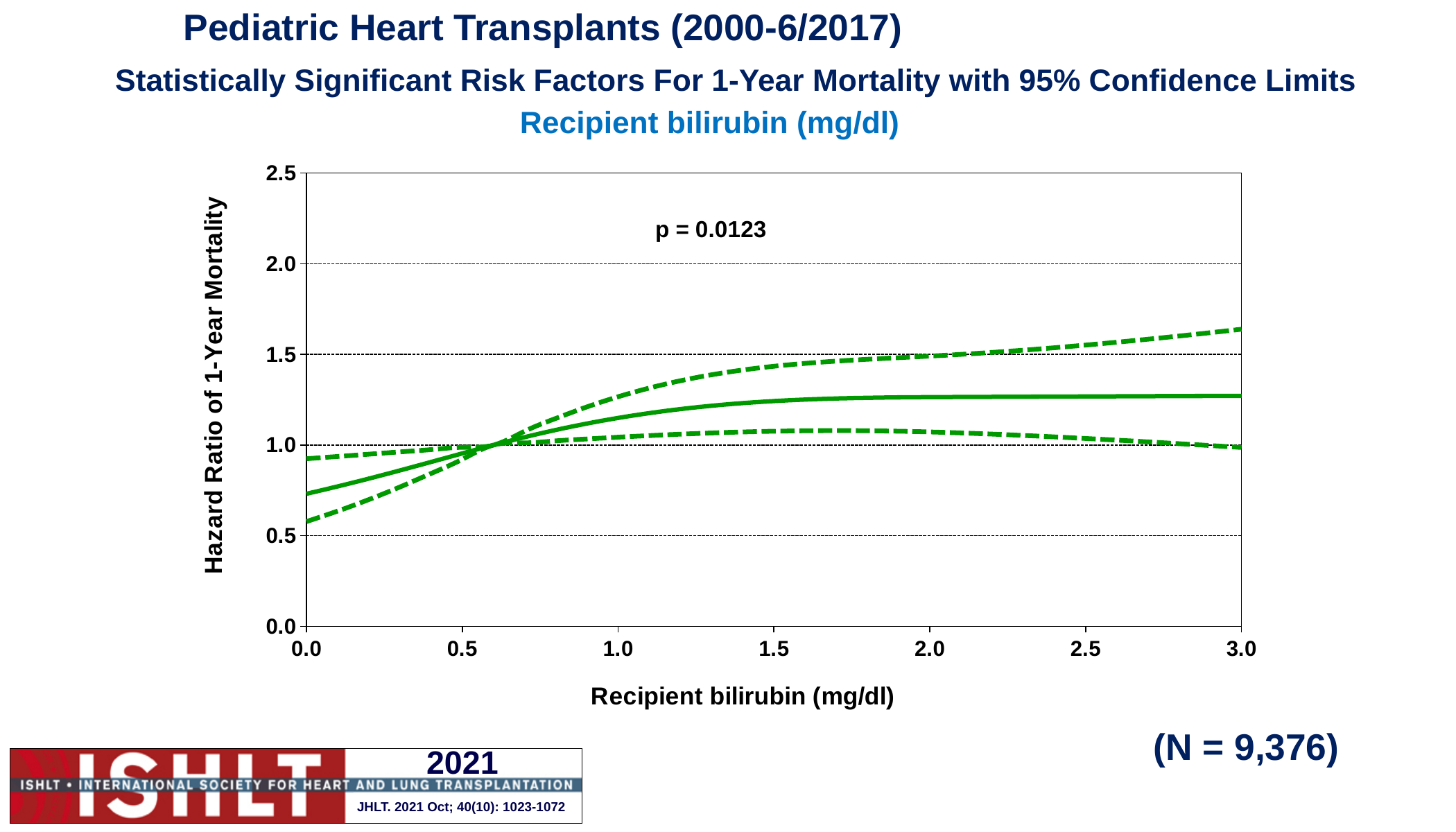
Is the hazard ratio (solid line) at a recipient bilirubin of 0.0 mg/dl greater or less than 1.0? less Is the upper dashed confidence limit at a recipient bilirubin of 3.0 mg/dl greater or less than 1.5? greater Is the lower dashed confidence limit at a recipient bilirubin of 0.0 mg/dl greater or less than 0.5? greater At which recipient bilirubin value on the x axis is the solid hazard ratio line at its lowest? 0.0 How many lines are plotted on the chart? 3 What is the label of the y axis? Hazard Ratio of 1-Year Mortality What kind of chart is shown on the slide? Line chart What p-value is printed on the chart? p = 0.0123 What is the highest value shown on the y axis? 2.5 Does the solid hazard ratio line rise or fall as recipient bilirubin increases from 0.0 to 3.0 mg/dl? Rise